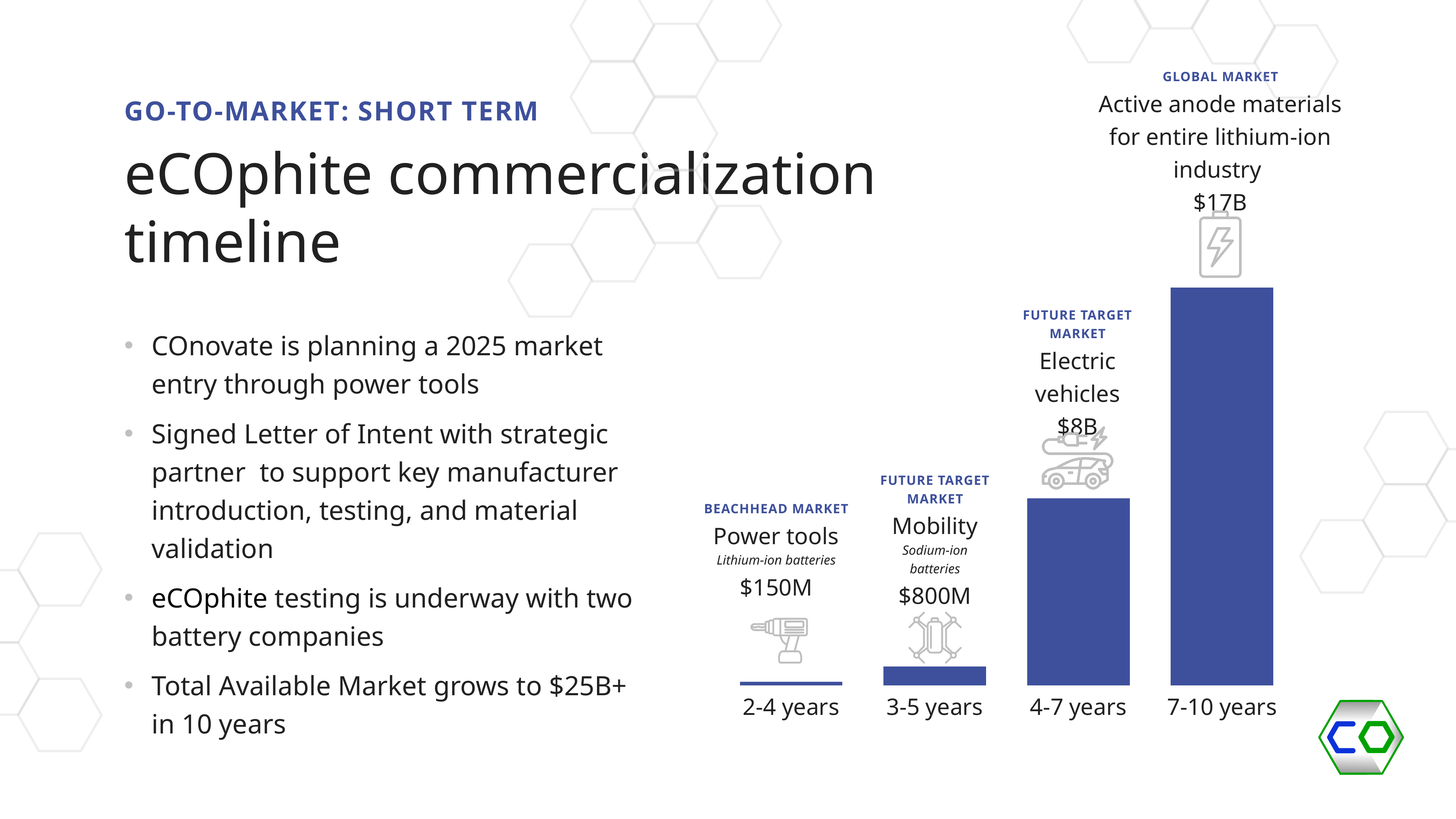
Which market has the largest bar in the chart? Active anode materials for entire lithium-ion industry Which market has the smallest bar in the chart? Power tools What is the market value shown for Power tools? $150M Which is larger, the Mobility market or the Electric vehicles market? Electric vehicles How many bars are shown in the chart? 4 Do the bar values rise or fall from left to right across the timeline? Rise What is the difference between the Global Market value ($17B) and the Electric vehicles value ($8B)? $9B What type of chart is shown on the slide? Bar chart What is the market value shown for Electric vehicles? $8B What is the difference between the Mobility value and the Power tools value? $650M What is the market value shown for Active anode materials for the entire lithium-ion industry? $17B What is the market value shown for Mobility? $800M